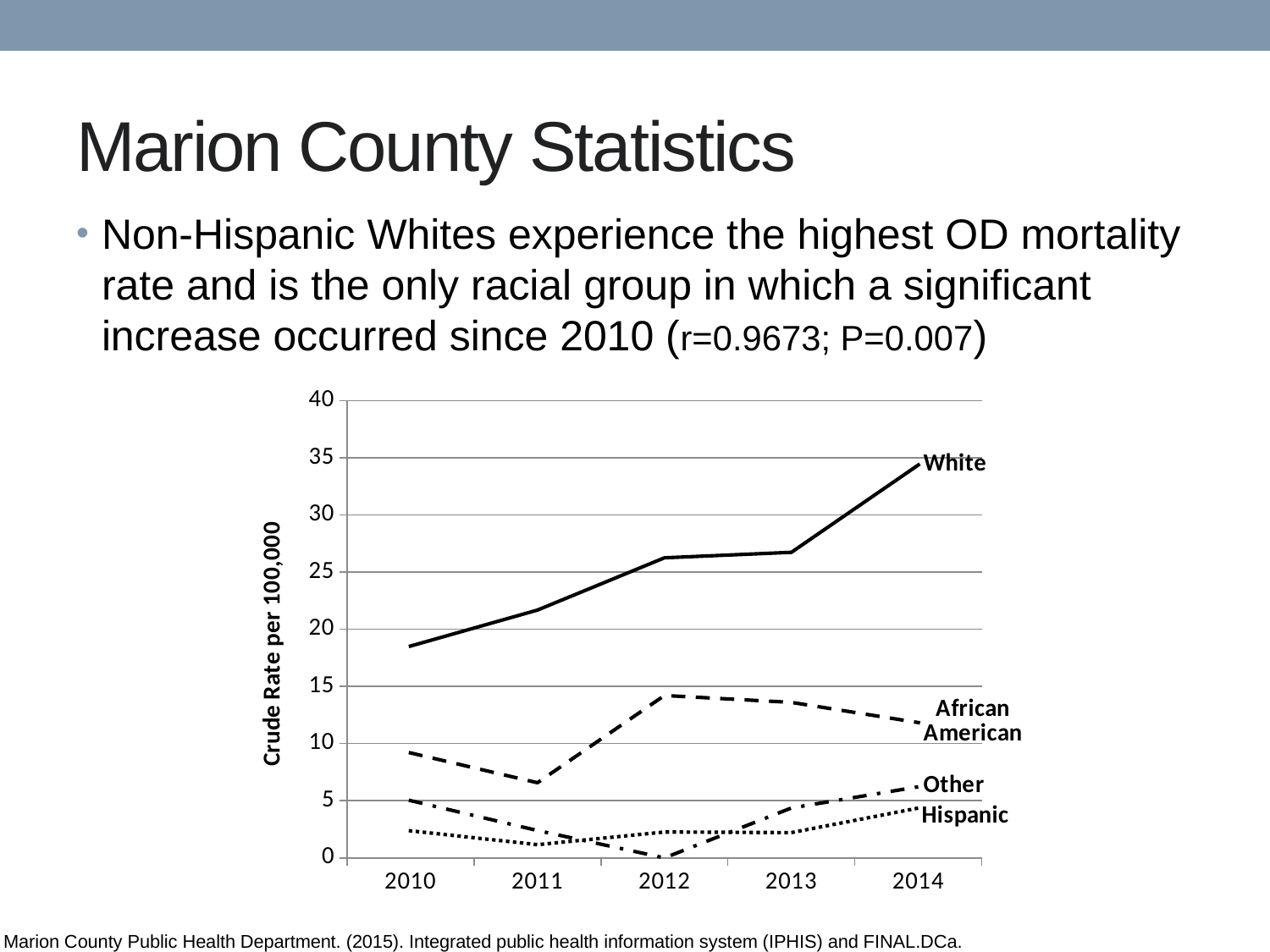
Which group has the highest crude rate in 2014? White In 2011, which group has the larger crude rate, African American or Other? African American Is the value for White in 2010 greater or less than 20? less Is the value for African American in 2012 greater or less than 10? greater How many racial groups are plotted as lines on the chart? 4 Which group has the lowest crude rate in 2012? Other Does the White line rise or fall from 2010 to 2014? rise Is the value for Hispanic in 2011 greater or less than 5? less How many years are plotted along the x axis of the chart? 5 What kind of chart is shown on the slide? line chart What is the label of the y axis of the chart? Crude Rate per 100,000